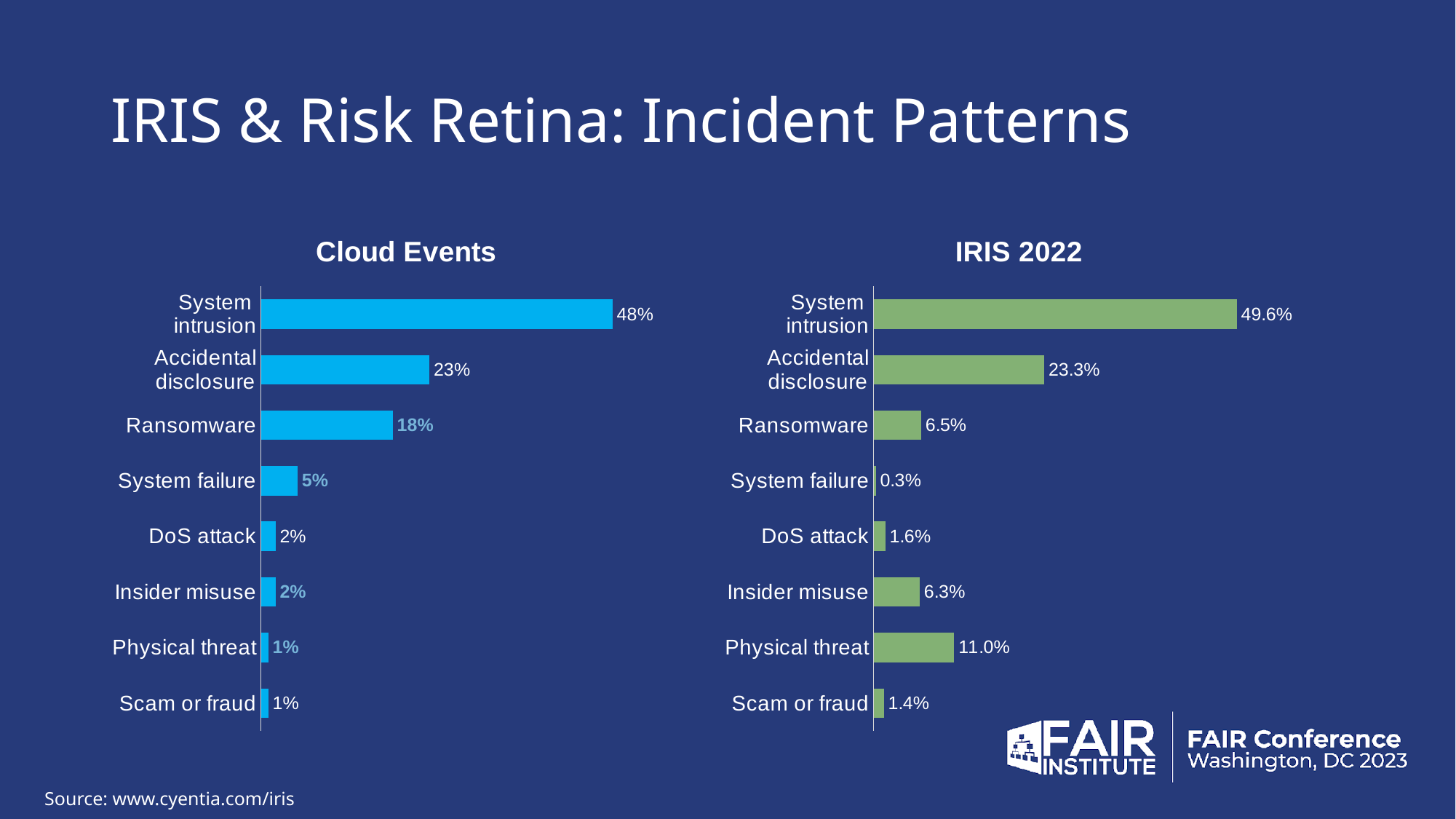
In the IRIS 2022 chart, what is the value for Ransomware? 6.5% What is the title of the chart on the left side of the slide? Cloud Events In the IRIS 2022 chart, which category has the lowest value? System failure In the IRIS 2022 chart, what is the difference between Accidental disclosure and Ransomware? 16.8% In the Cloud Events chart, what is the difference between System intrusion and Accidental disclosure? 25% In the Cloud Events chart, what is the value for System intrusion? 48% How many categories does the Cloud Events chart show? 8 In the IRIS 2022 chart, what is the value for Physical threat? 11.0% Which is larger, Ransomware in the Cloud Events chart or Ransomware in the IRIS 2022 chart? Cloud Events What kind of chart is the IRIS 2022 chart? Bar chart In the IRIS 2022 chart, which is larger, Physical threat or Insider misuse? Physical threat In the Cloud Events chart, which category has the highest value? System intrusion